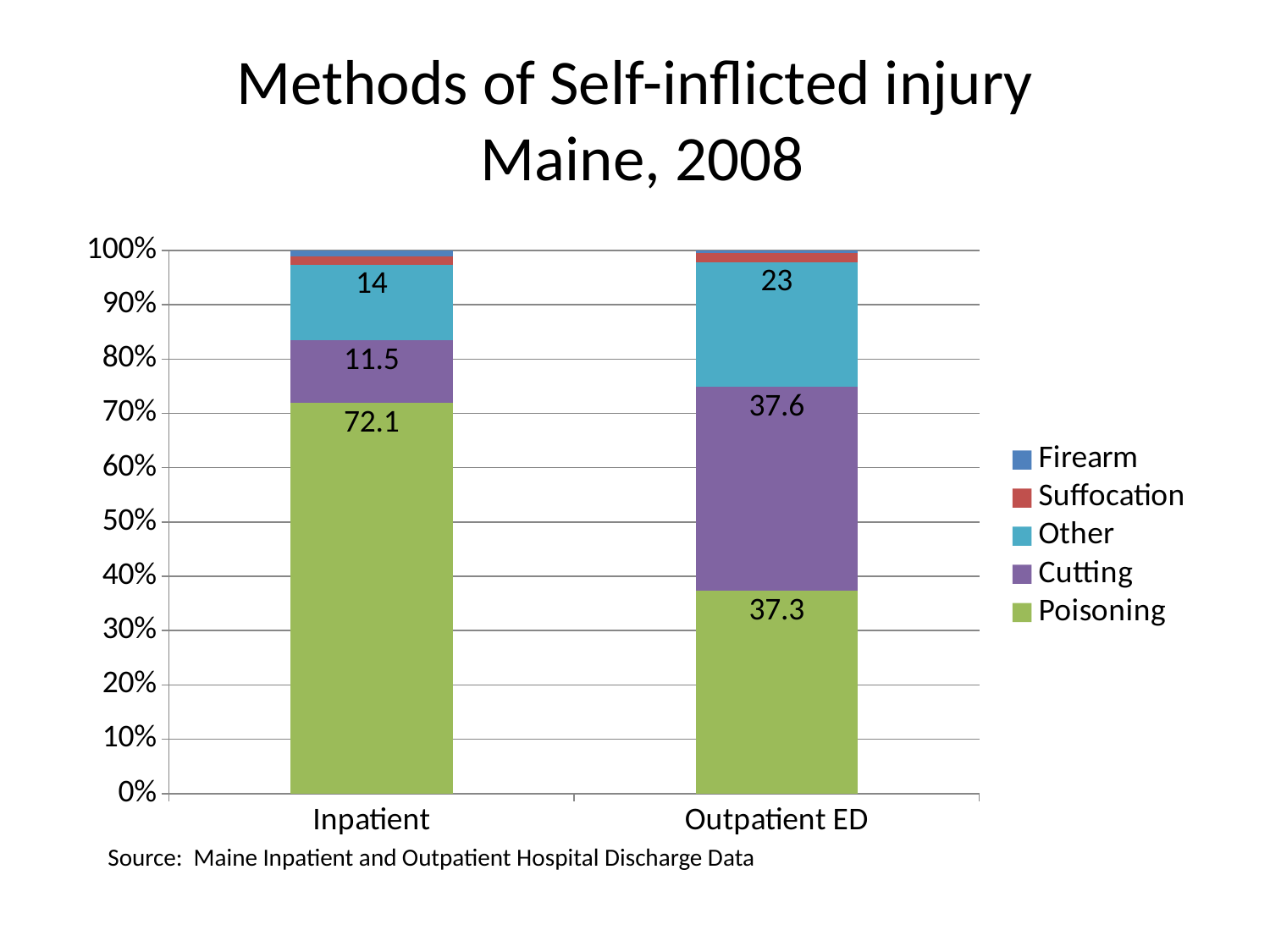
What is the difference between the Cutting values for Outpatient ED and Inpatient? 26.1 How many categories are shown on the x axis? 2 What kind of chart is shown on the slide? Stacked bar chart Which is larger, the Other value for Inpatient or for Outpatient ED? Outpatient ED What is the value for Poisoning in the Outpatient ED bar? 37.3 What is the value for Cutting in the Outpatient ED bar? 37.6 What is the value for Poisoning in the Inpatient bar? 72.1 Is the value for Firearm in the Inpatient bar greater or less than 10%? less What is the value for Other in the Inpatient bar? 14 How many series does the legend list? 5 Which method makes up the largest share of the Inpatient bar? Poisoning What is the difference between the Poisoning values for Inpatient and Outpatient ED? 34.8